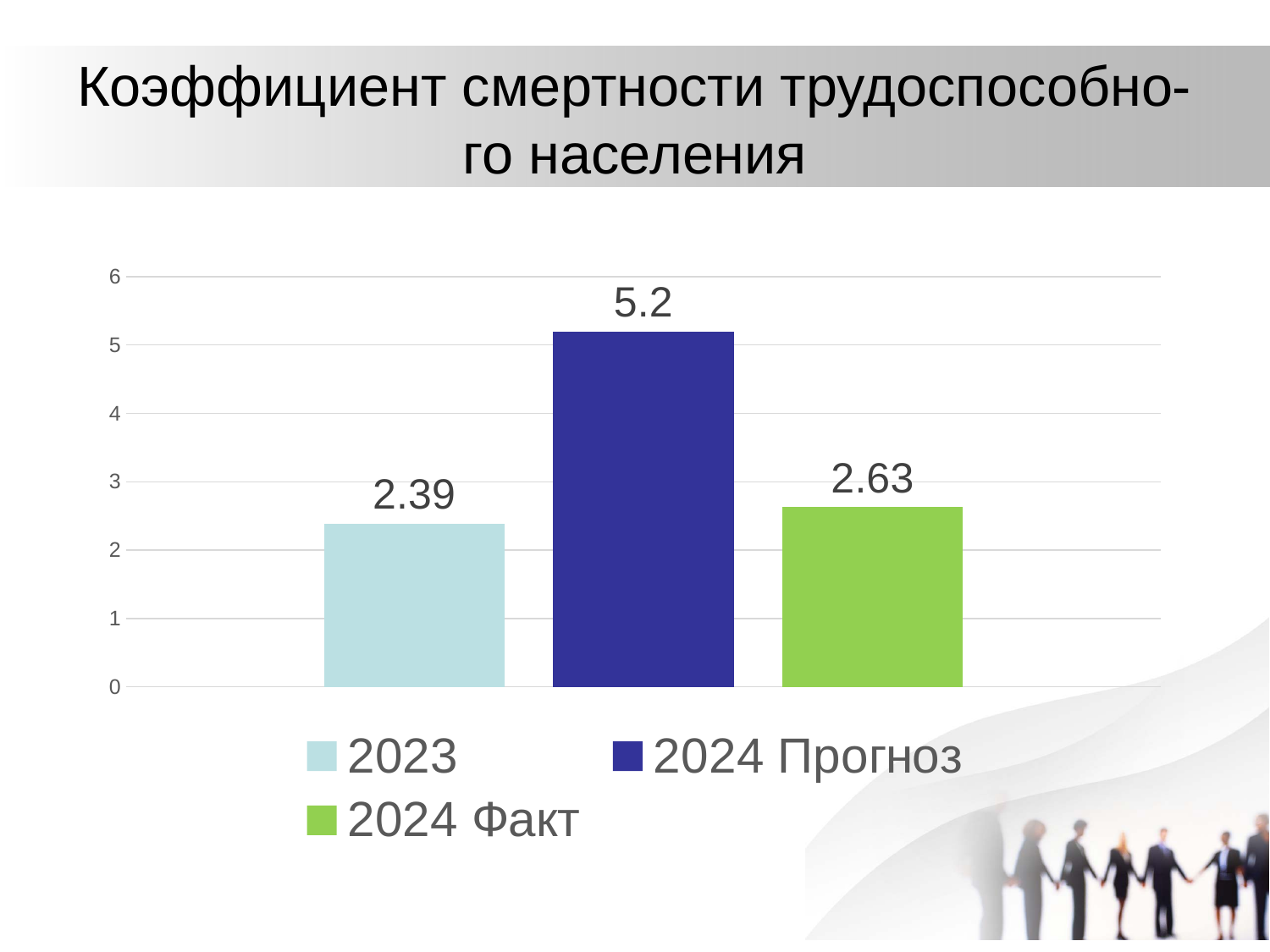
What is the value for 2024 Факт? 2.63 Which series has the highest value? 2024 Прогноз How many series does the legend list? 3 Which is larger, the value for 2023 or the value for 2024 Факт? 2024 Факт What is the value for 2023? 2.39 What kind of chart is shown on the slide? bar chart Which series has the lowest value? 2023 What is the difference between the 2024 Прогноз value and the 2024 Факт value? 2.57 What is the value for 2024 Прогноз? 5.2 What is the title of the chart on the slide? Коэффициент смертности трудоспособного населения What is the difference between the 2024 Факт value and the 2023 value? 0.24 Is the value for 2024 Прогноз greater or less than 5? greater